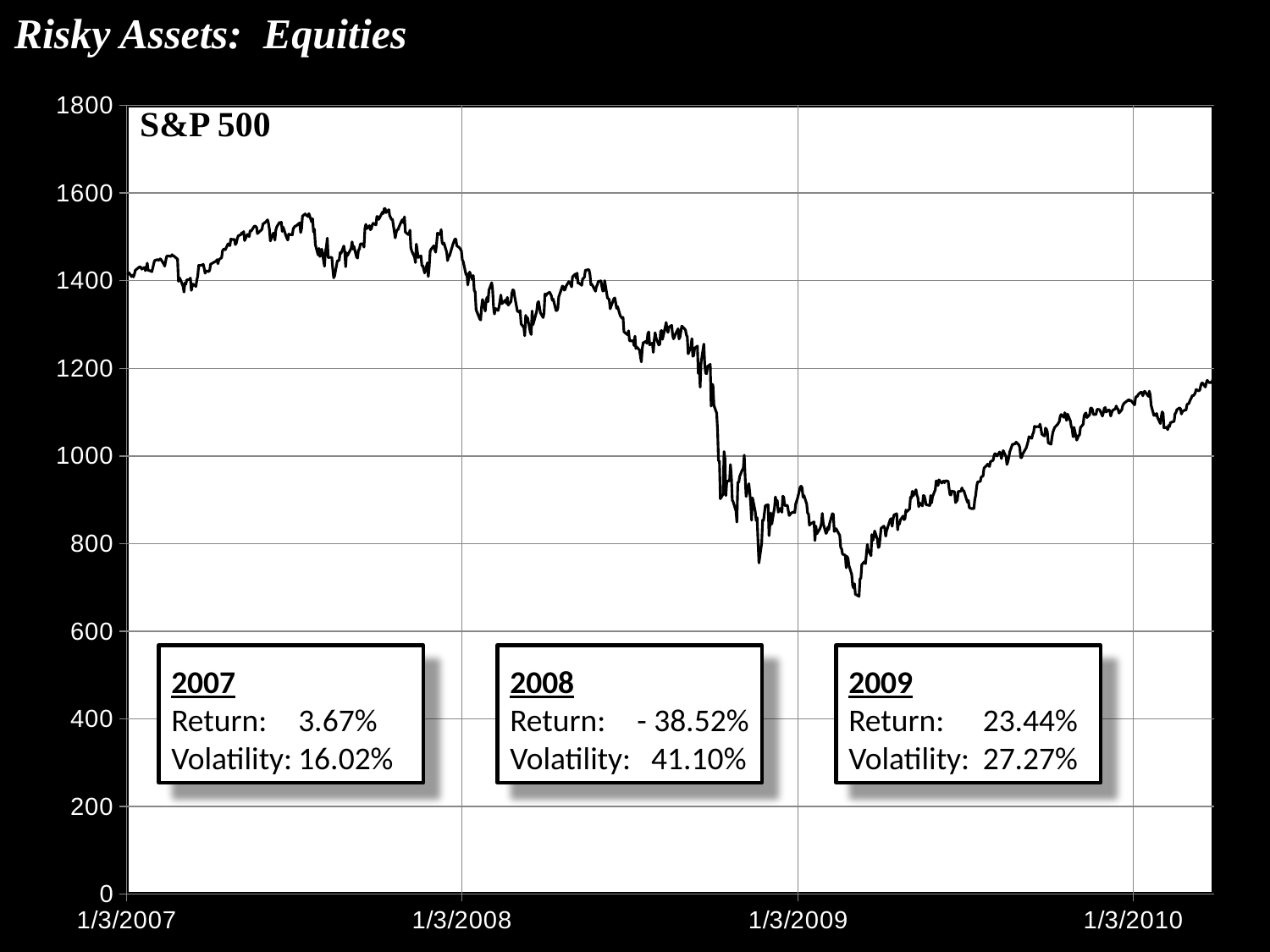
Which year shown in the annotation boxes had the highest volatility? 2008 What is the label shown inside the plot area identifying the series? S&P 500 What was the return for 2009 according to the annotation box? 23.44% Does the S&P 500 line rise or fall between 1/3/2009 and 1/3/2010? rise What kind of chart is shown on the slide? line chart Is the S&P 500 value at 1/3/2009 greater or less than 1000? less Which is larger, the volatility for 2008 or the volatility for 2009? 2008 Is the lowest point of the S&P 500 line, reached in early 2009, greater or less than 800? less What was the return for 2007 according to the annotation box? 3.67% What is the difference between the 2009 volatility and the 2007 volatility? 11.25% What was the volatility for 2008 according to the annotation box? 41.10% Which year shown in the annotation boxes had the lowest return? 2008